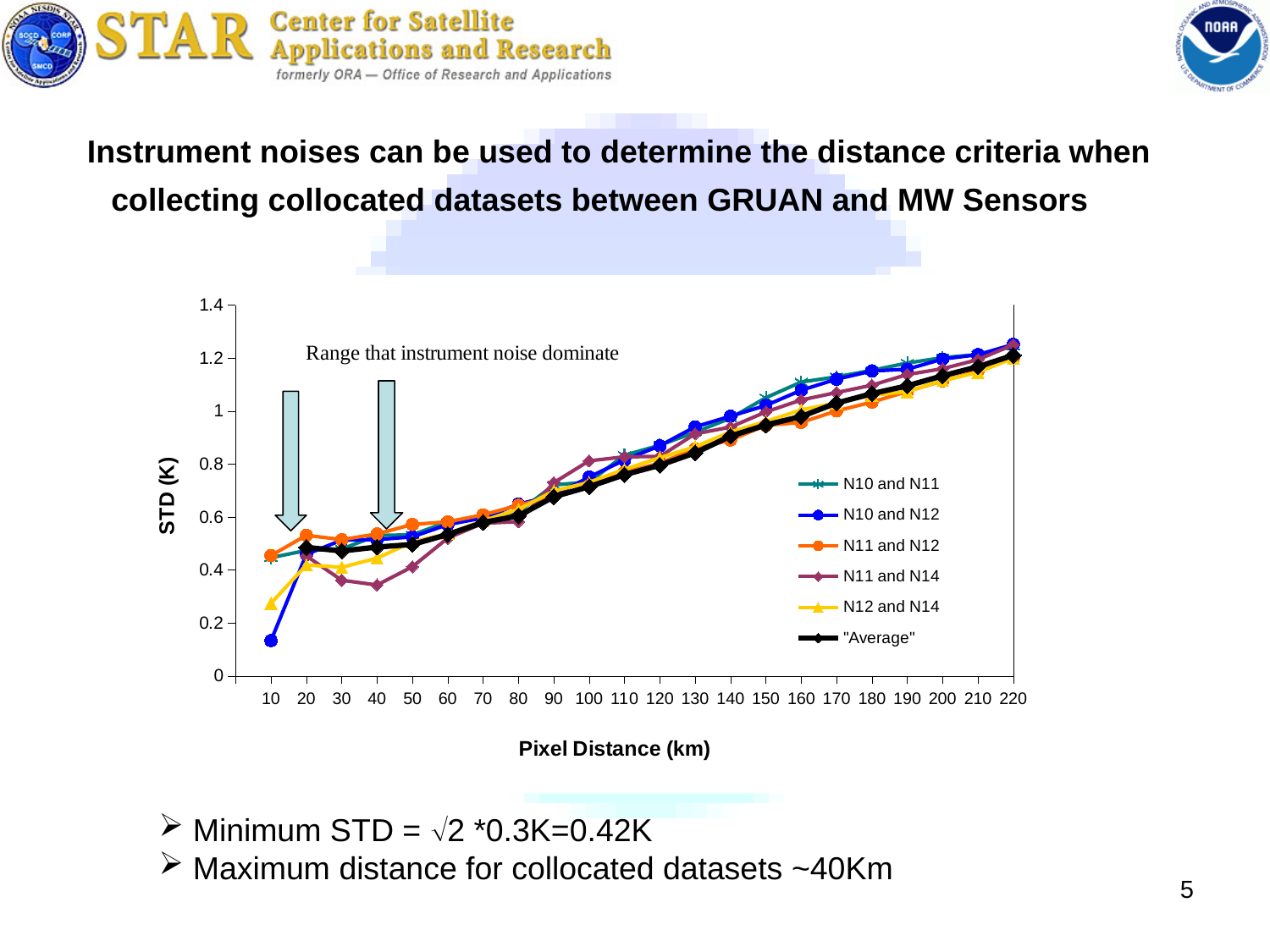
Is the STD for N10 and N11 at 160 km greater or less than 1? greater Is the STD for N11 and N14 at 40 km greater or less than 0.4? less What kind of chart is shown on the slide? line chart What is the label of the y axis? STD (K) Is the STD for N10 and N12 at 10 km greater or less than 0.2? less Do the STD values generally rise or fall as pixel distance increases? rise Which series has the lowest STD at a pixel distance of 10 km? N10 and N12 At 10 km, which series has the larger STD: N11 and N12 or N10 and N12? N11 and N12 How many series does the legend list? 6 What text annotation appears above the arrows in the chart? Range that instrument noise dominate How many pixel distance values are marked along the x axis? 22 Which series has the lowest STD at a pixel distance of 40 km? N11 and N14